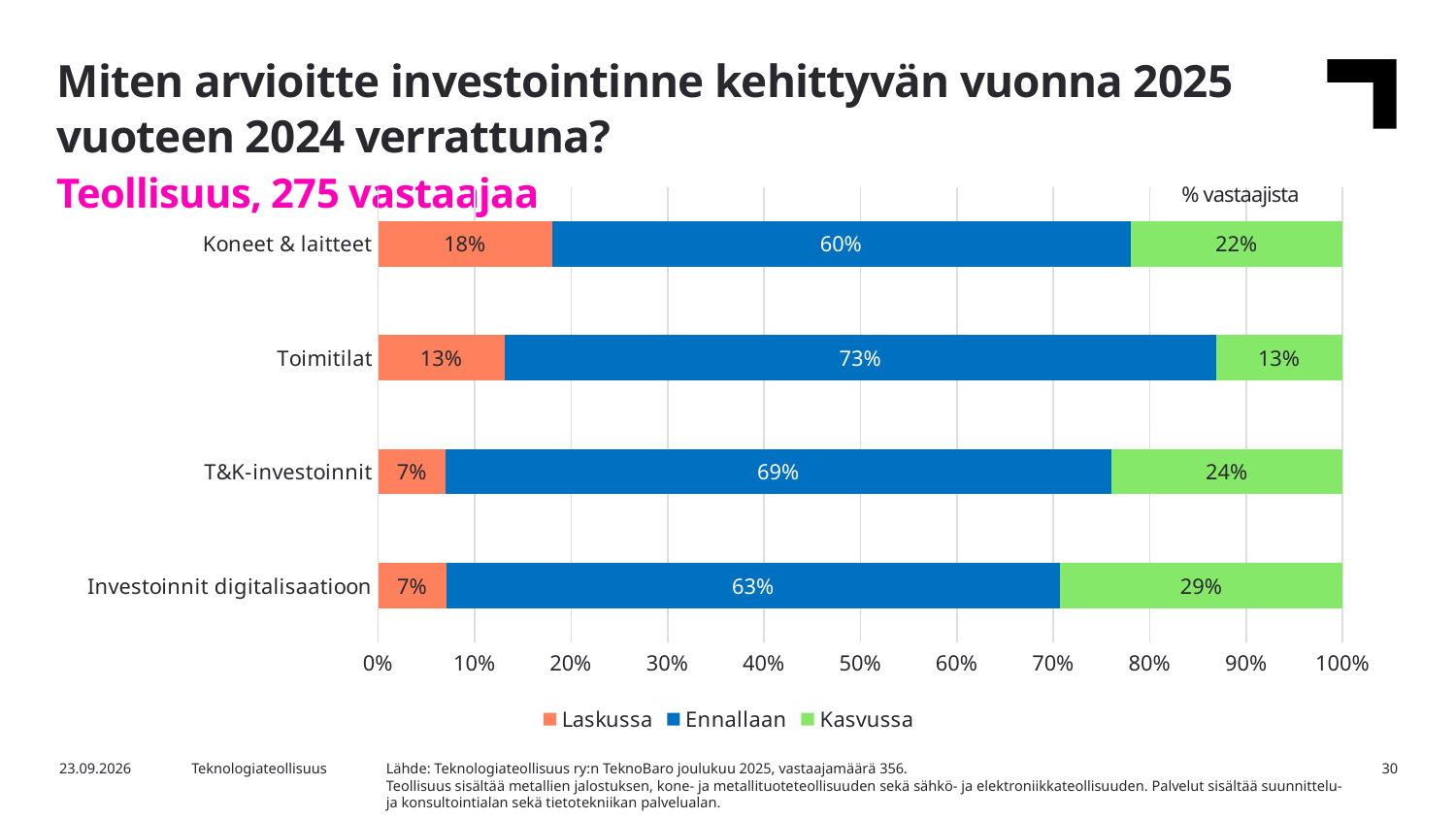
What is the difference between the Kasvussa values for T&K-investoinnit and Toimitilat? 11% What kind of chart is shown on the slide? Stacked bar chart What are the three series listed in the legend? Laskussa, Ennallaan, Kasvussa What is the Ennallaan value for Toimitilat? 73% What is the Laskussa value for Koneet & laitteet? 18% How many series does the legend list? 3 Which category has the lowest Ennallaan value? Koneet & laitteet How many categories are shown on the chart? 4 What is the total of the stacked bar for T&K-investoinnit? 100% What is the Kasvussa value for Investoinnit digitalisaatioon? 29% Which category has the highest Kasvussa value? Investoinnit digitalisaatioon Which is larger: the Laskussa value for Koneet & laitteet or the Laskussa value for Toimitilat? Koneet & laitteet